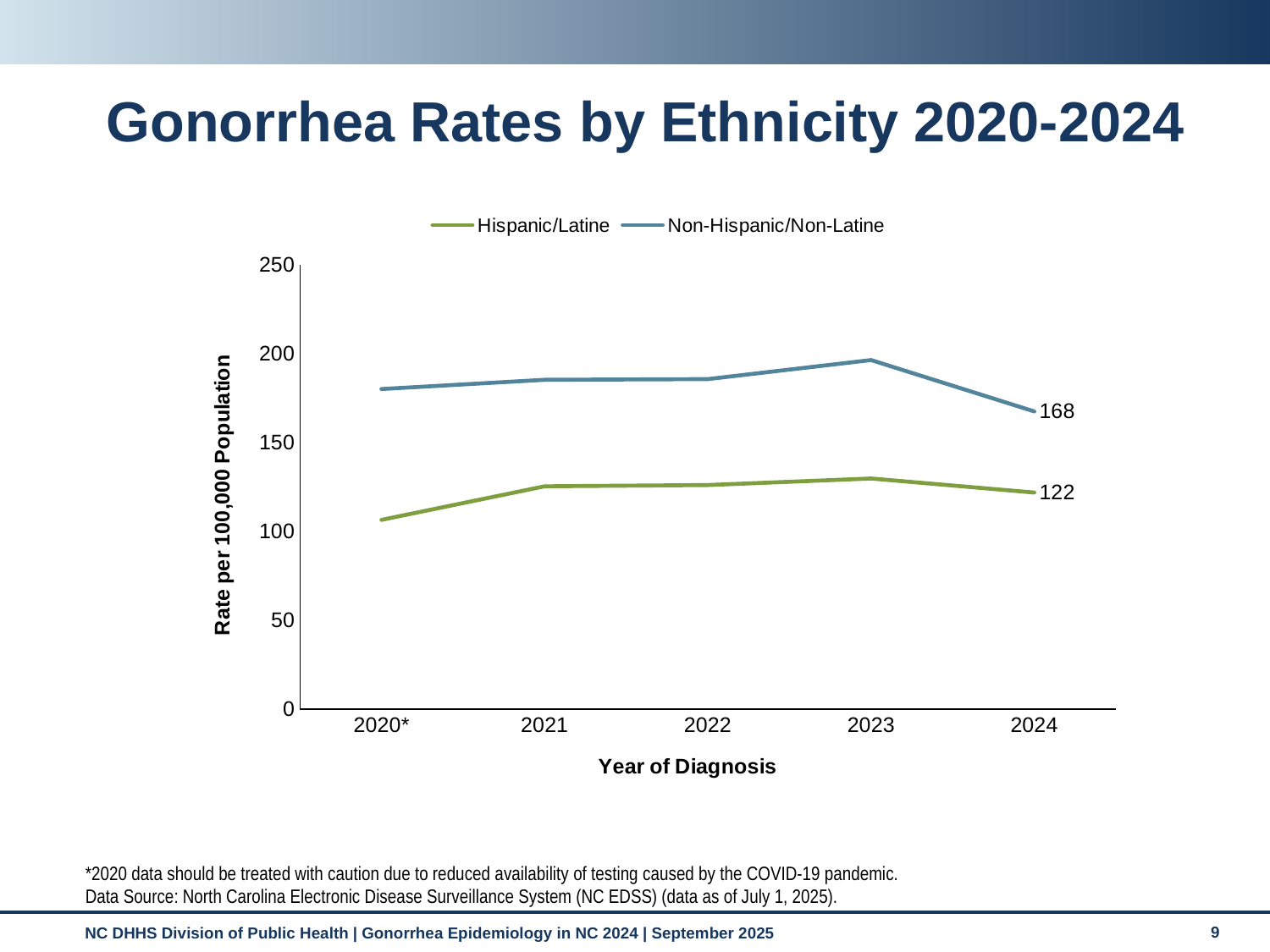
What kind of chart is shown on the slide? Line chart In which year is the Non-Hispanic/Non-Latine rate highest? 2023 What is the gonorrhea rate for Non-Hispanic/Non-Latine in 2024? 168 How many series does the legend list? 2 In which year is the Hispanic/Latine rate lowest? 2020* Is the Hispanic/Latine rate in 2021 greater or less than 150? less Did the Non-Hispanic/Non-Latine rate rise or fall from 2023 to 2024? Fall Which group has the higher gonorrhea rate in 2024, Hispanic/Latine or Non-Hispanic/Non-Latine? Non-Hispanic/Non-Latine Is the Non-Hispanic/Non-Latine rate in 2023 greater or less than 150? greater How many years are shown on the x axis? 5 What is the gonorrhea rate for Hispanic/Latine in 2024? 122 What is the difference between the Non-Hispanic/Non-Latine and Hispanic/Latine rates in 2024? 46